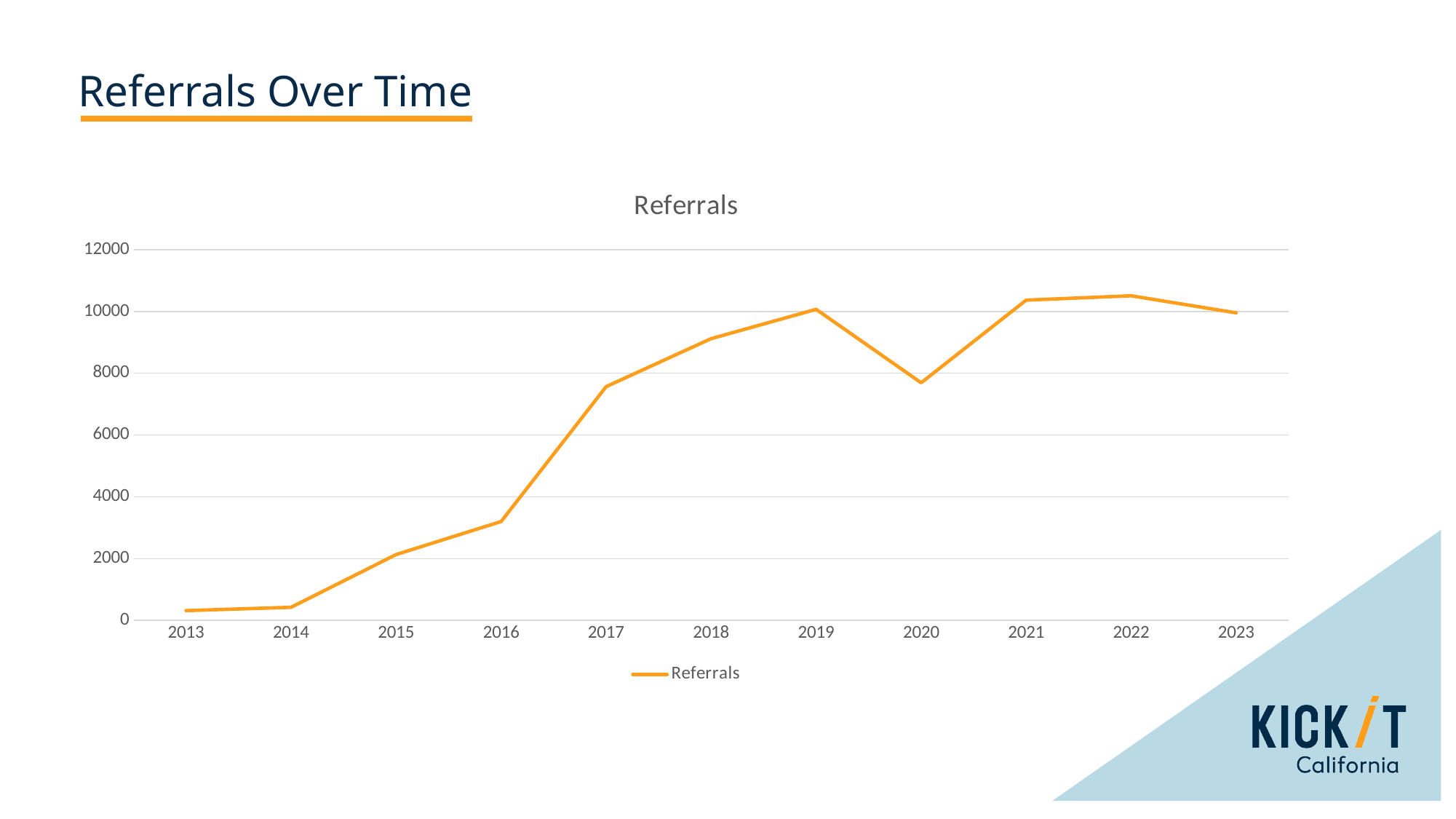
Which year has the larger number of referrals, 2019 or 2020? 2019 Is the value for 2014 greater or less than 2000? less What kind of chart is shown on the slide? line chart What is the title shown above the chart? Referrals Which year has the larger number of referrals, 2016 or 2017? 2017 How many series does the legend of the Referrals chart list? 1 Is the value for 2016 greater or less than 4000? less Do referrals rise or fall from 2013 to 2019? rise How many years are plotted along the x axis of the Referrals chart? 11 Is the value for 2017 greater or less than 6000? greater